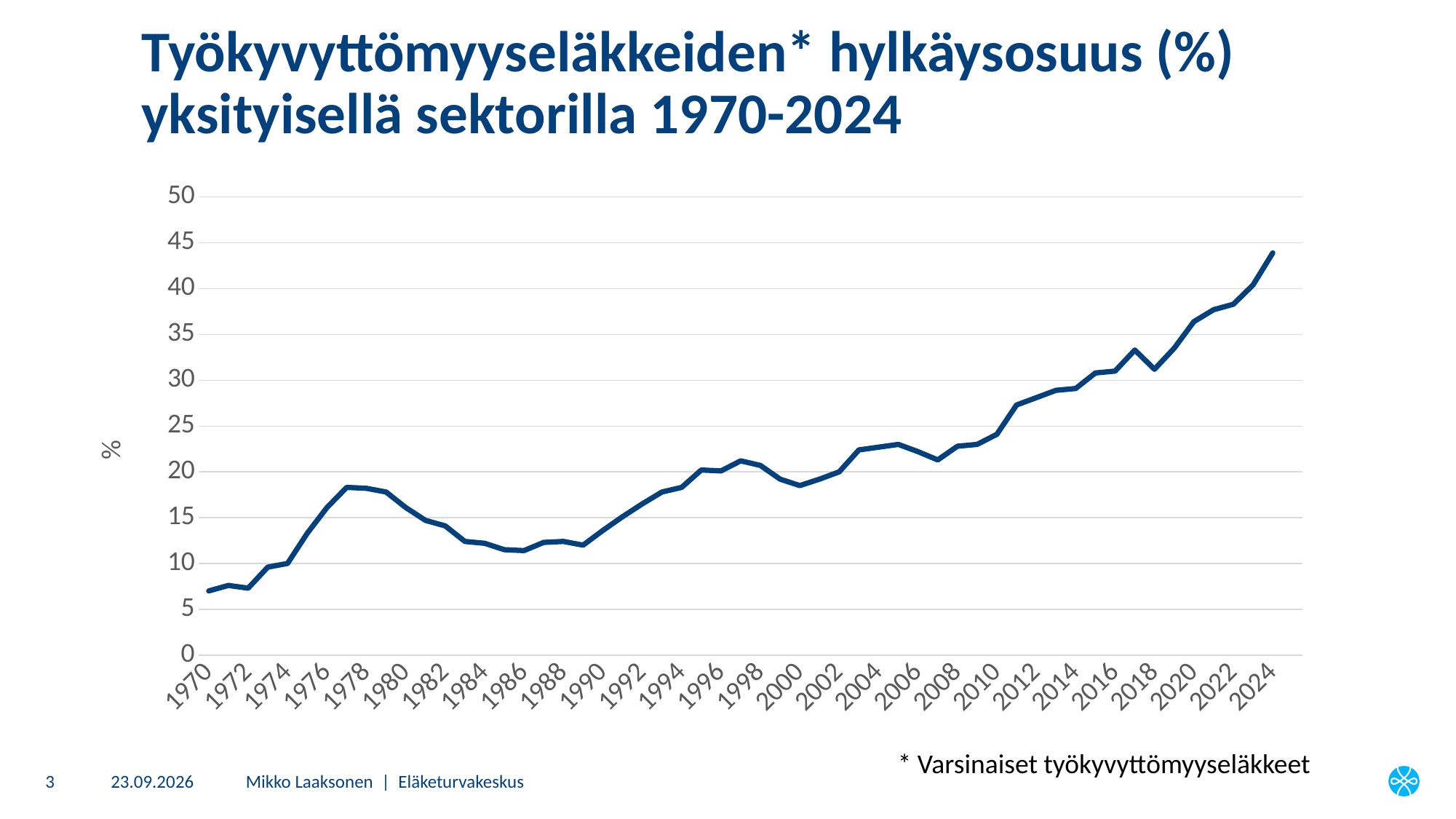
Is the value for 2024 greater or less than 40? greater Is the value for 2020 greater or less than 35? greater Overall, does the rejection share rise or fall from 1970 to 2024? rise Is the value for 1977 greater or less than 15? greater Which year has the larger value, 1977 or 1985? 1977 What kind of chart is shown on the slide? line chart What is the label on the vertical axis of the chart? % Which year has the highest rejection share in the chart? 2024 Which year has the larger value, 2005 or 2000? 2005